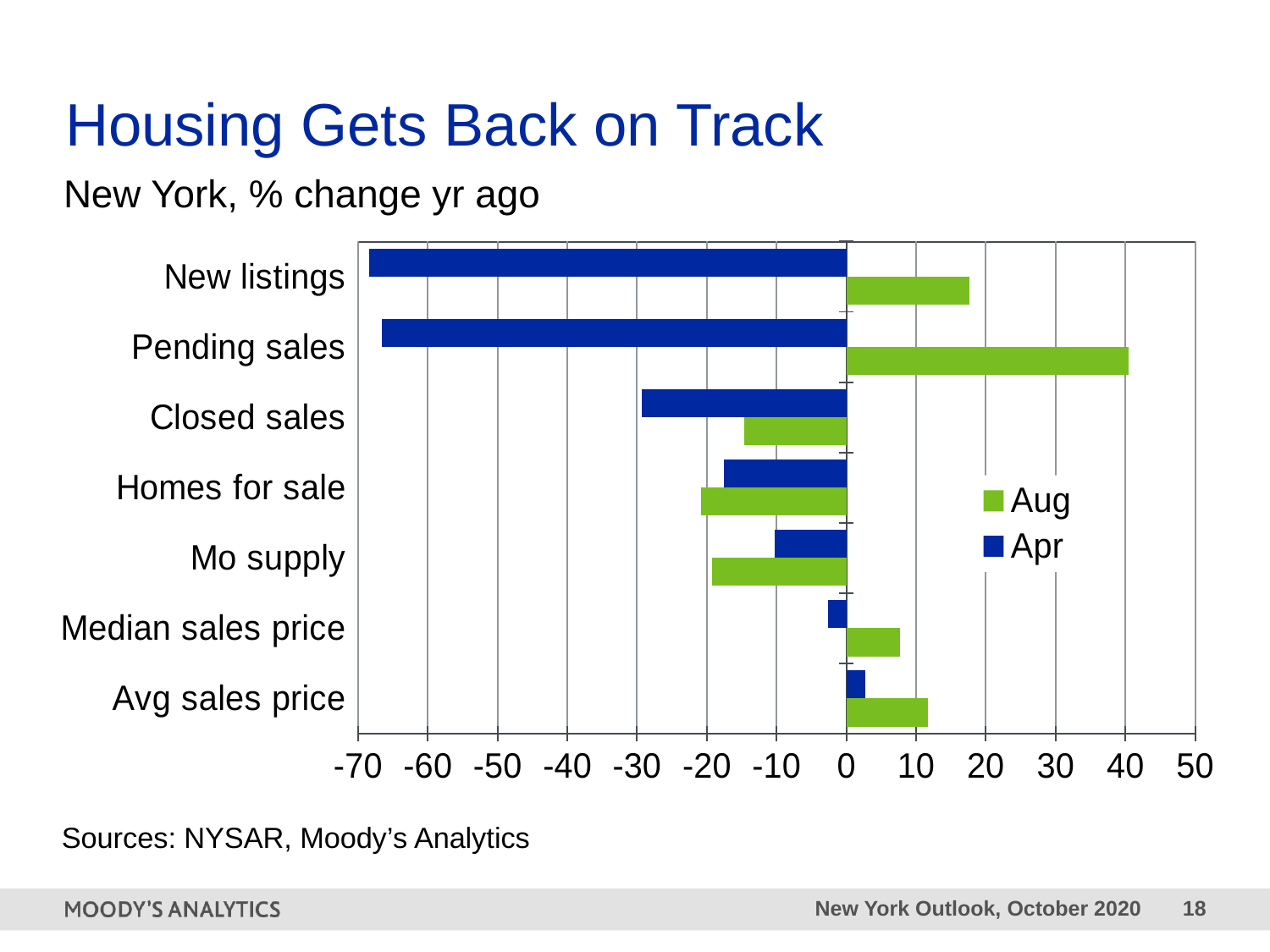
Is the Apr value for Closed sales greater or less than -20? less Which colour represents the Apr series in the legend? blue For Pending sales, which is larger, the Aug value or the Apr value? Aug Is the Aug value for Pending sales greater or less than 30? greater How many categories are shown on the chart? 7 Which category has the highest Apr value? Avg sales price Is the Apr value for New listings greater or less than -60? less What kind of chart is shown on the slide? bar chart How many series does the legend list? 2 Which category has the highest Aug value? Pending sales Which is larger, the Apr value for Mo supply or the Apr value for Closed sales? Mo supply